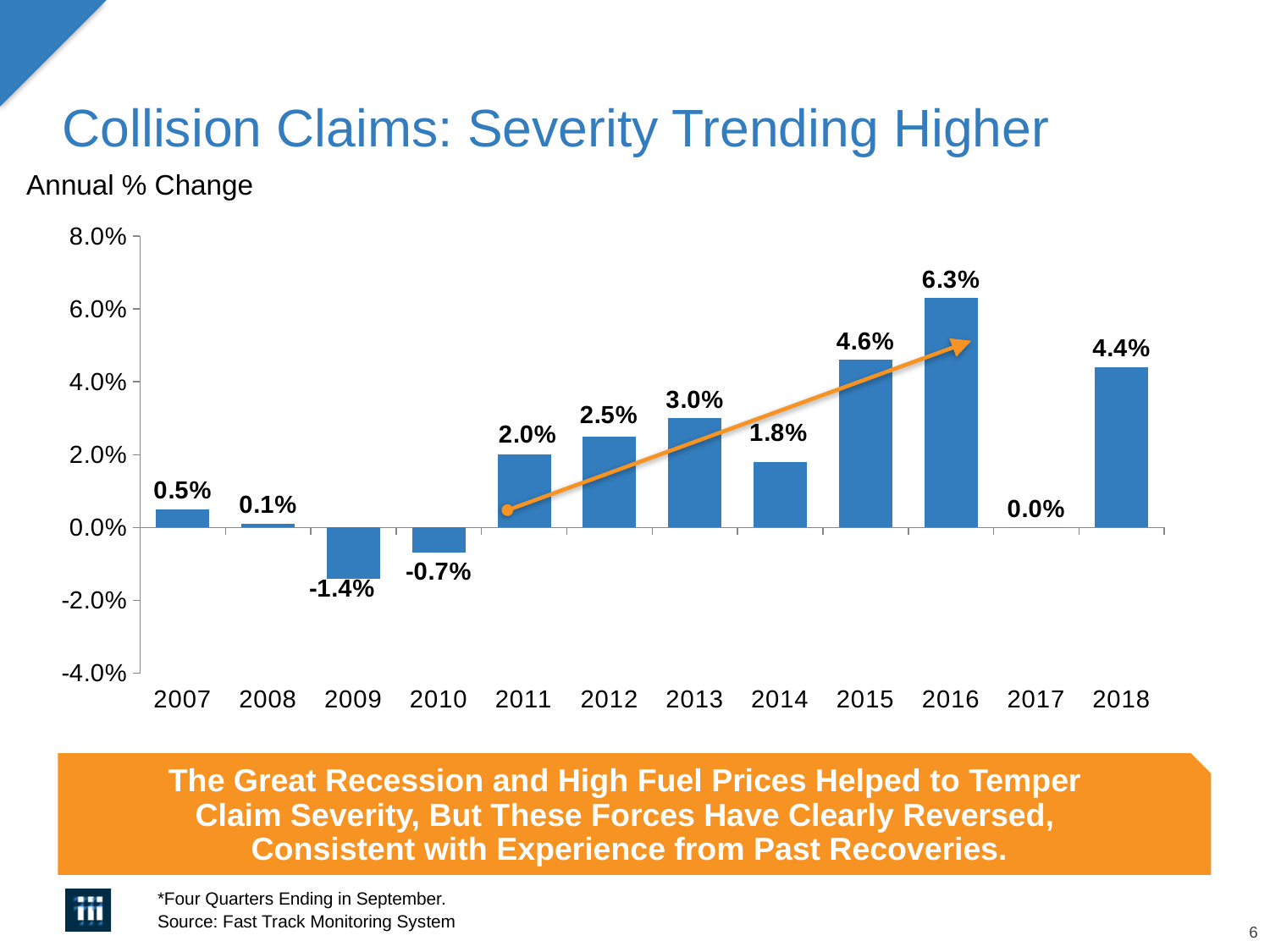
What is the annual % change shown for 2009? -1.4% What is the difference between the values for 2016 and 2015? 1.7% Which year has the highest annual % change? 2016 What is the value shown for 2018? 4.4% Which year has the larger value, 2013 or 2014? 2013 How many years show a negative annual % change? 2 What kind of chart is shown on the slide? Bar chart What is the title of the chart on the slide? Collision Claims: Severity Trending Higher What is the annual % change in collision claim severity for 2016? 6.3% Which year has the lowest annual % change? 2009 How many years are shown on the x axis? 12 Do the values generally rise or fall from 2011 to 2016? Rise